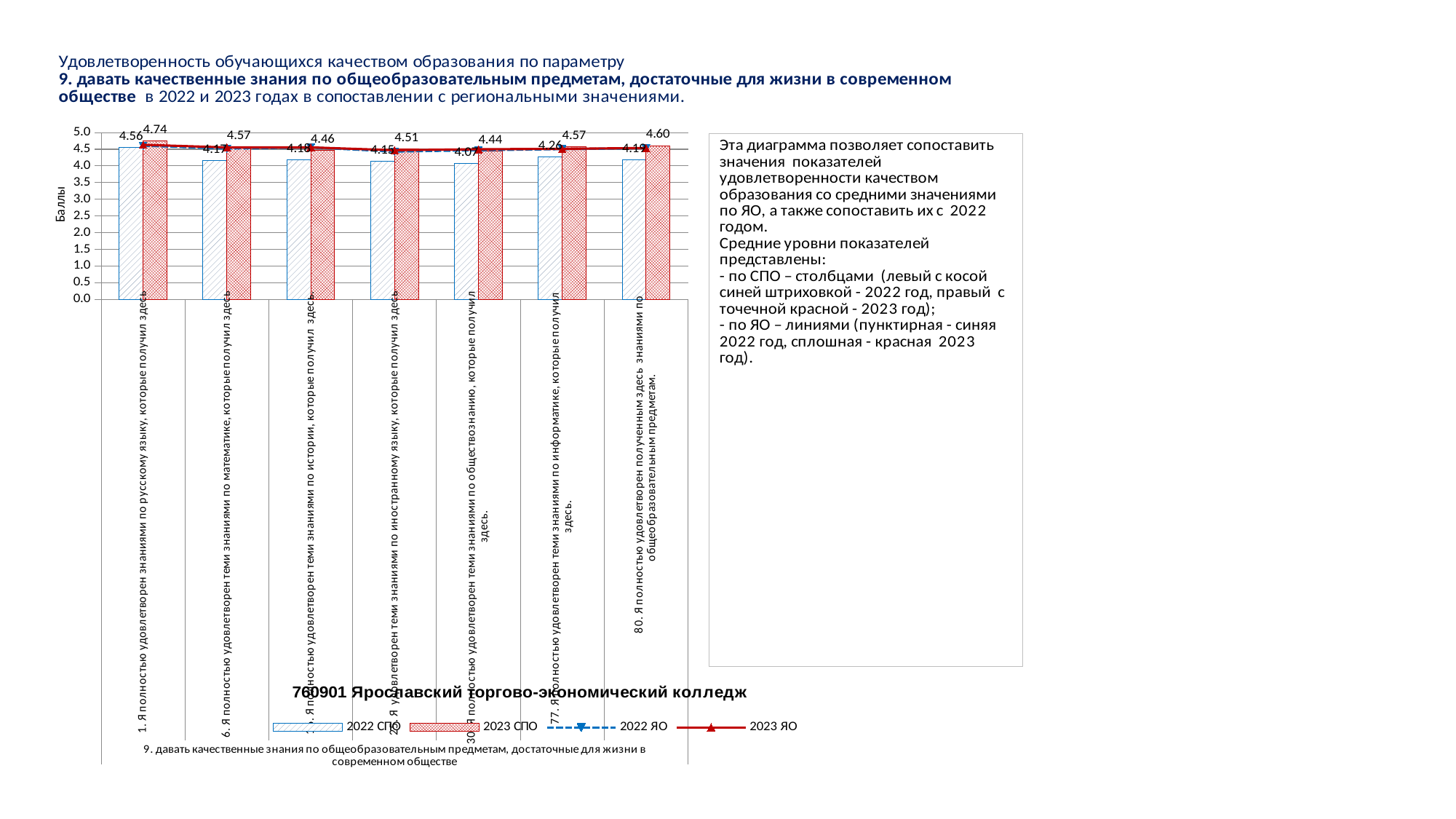
What is the 2022 СПО value for the category about knowledge of social studies (обществознанию)? 4.07 What is the 2022 СПО value for the category about knowledge of history (истории)? 4.18 Which category has the highest 2023 СПО value? 1. Я полностью удовлетворен знаниями по русскому языку, которые получил здесь What is the 2023 СПО value for the category about knowledge of informatics (информатике)? 4.57 How many categories are shown on the x axis of the chart? 7 Which category has the lowest 2022 СПО value? 30. Я полностью удовлетворен теми знаниями по обществознанию, которые получил здесь Which is larger for the category about mathematics (математике): the 2022 СПО value or the 2023 СПО value? 2023 СПО What is the 2023 СПО value for the category about knowledge of Russian language (русскому языку)? 4.74 What is the label of the vertical axis of the chart? Баллы How many series does the chart legend list? 4 Is the 2022 СПО value for the category about social studies (обществознанию) greater or less than 4.5? less What is the difference between the 2023 СПО and 2022 СПО values for the category about Russian language? 0.18